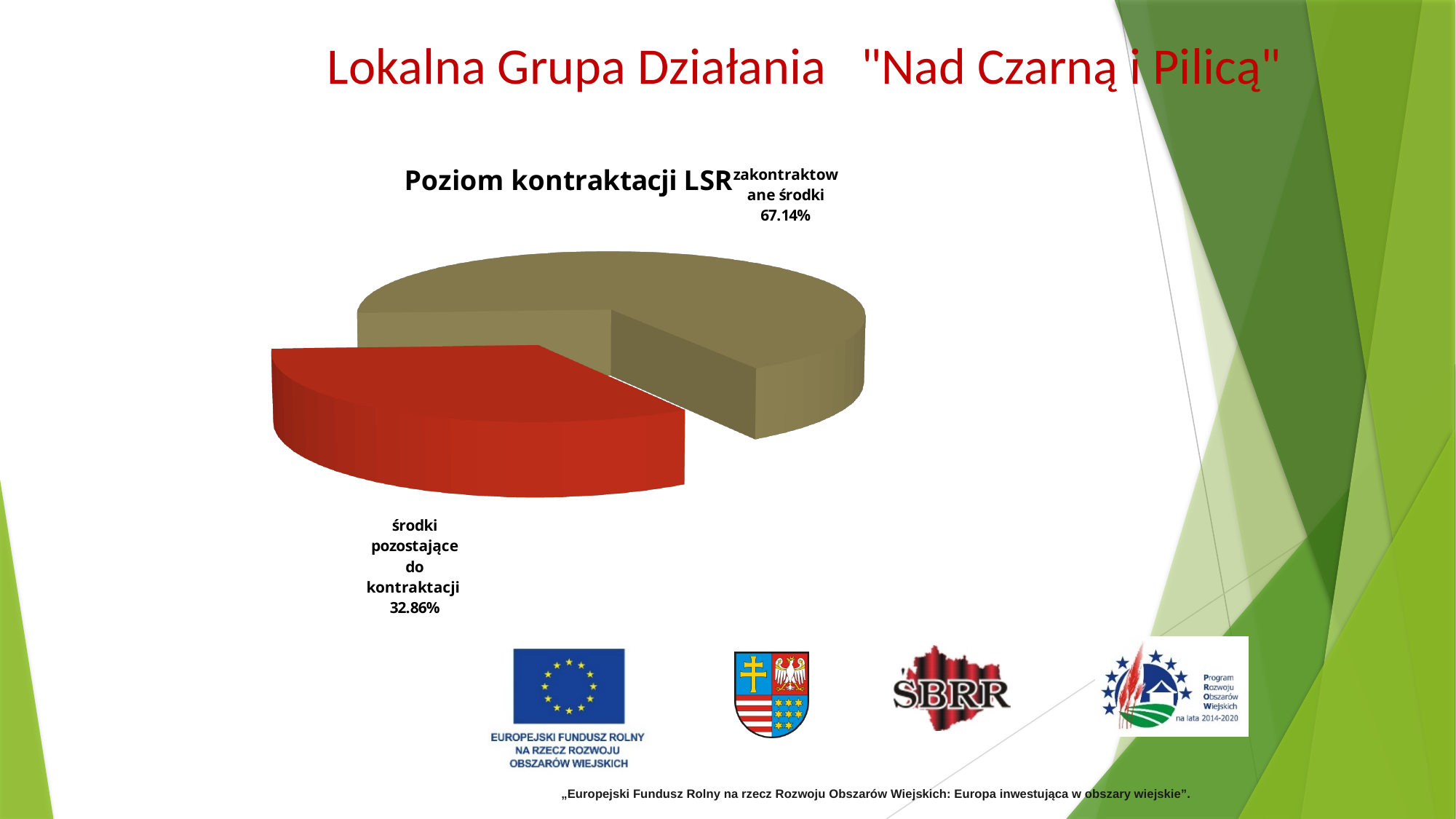
What is the title of the chart? Poziom kontraktacji LSR What is the difference in percentage points between 'zakontraktowane środki' and 'środki pozostające do kontraktacji'? 34.28 Which slice of the pie is the largest? zakontraktowane środki Which slice of the pie is the smallest? środki pozostające do kontraktacji What colour is the slice for 'środki pozostające do kontraktacji'? red How many slices does the pie chart have? 2 What share of the pie does 'zakontraktowane środki' represent? 67.14% What percentage is shown for 'środki pozostające do kontraktacji'? 32.86% Which is larger: 'zakontraktowane środki' or 'środki pozostające do kontraktacji'? zakontraktowane środki What kind of chart is shown on the slide? pie chart What percentage is shown for 'zakontraktowane środki'? 67.14%